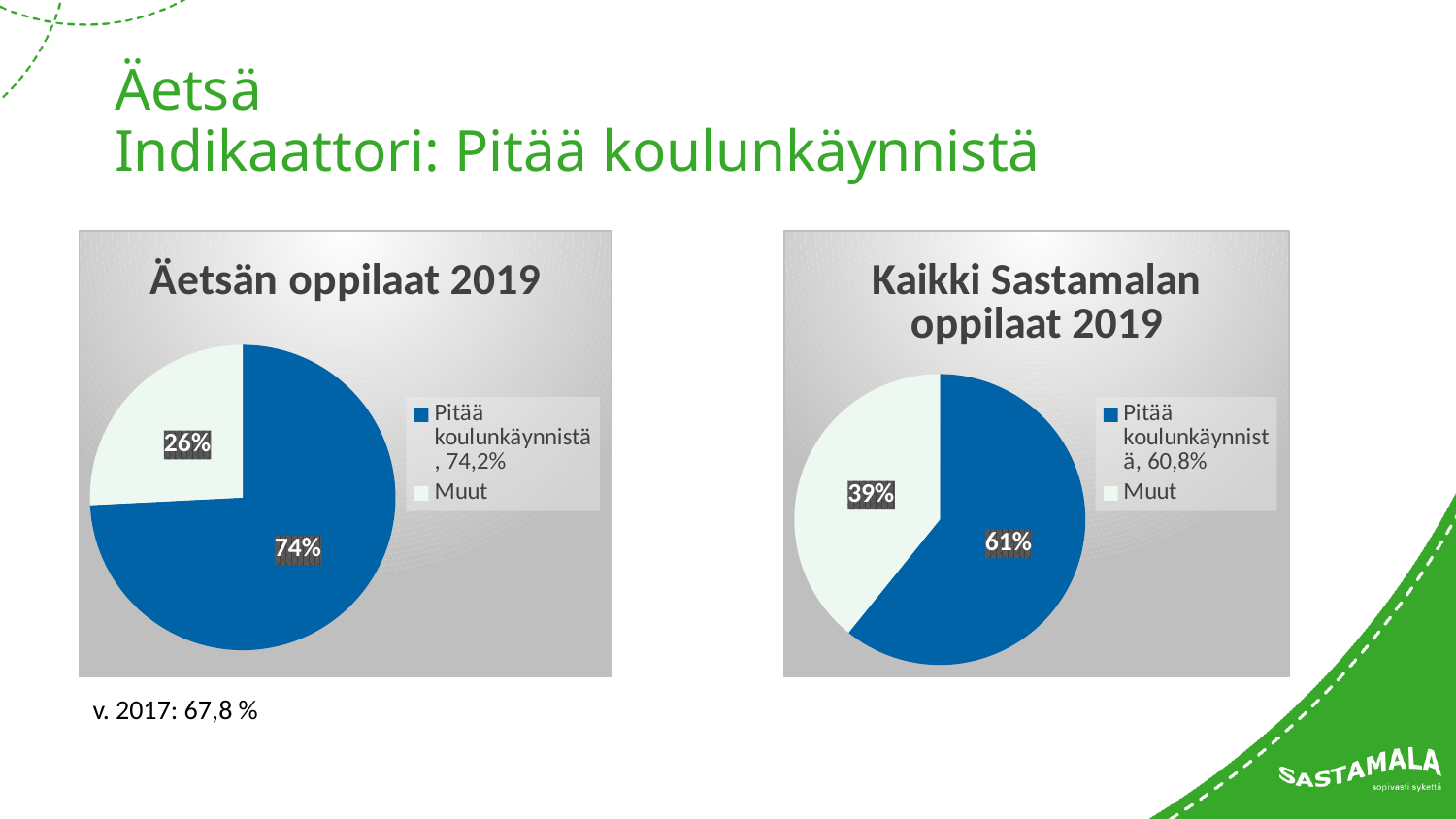
How many slices does the chart titled "Äetsän oppilaat 2019" have? 2 In the chart titled "Äetsän oppilaat 2019", what is the difference in percentage points between the "Pitää koulunkäynnistä" slice and the "Muut" slice, using the labels on the slices? 48 Which is larger: the "Pitää koulunkäynnistä" share in the "Äetsän oppilaat 2019" chart or in the "Kaikki Sastamalan oppilaat 2019" chart? Äetsän oppilaat 2019 In the chart titled "Äetsän oppilaat 2019", what percentage is shown on the "Muut" slice? 26% In the legend of the chart titled "Äetsän oppilaat 2019", what value is given next to "Pitää koulunkäynnistä"? 74,2% What kind of chart is the chart titled "Kaikki Sastamalan oppilaat 2019"? Pie chart In the chart titled "Kaikki Sastamalan oppilaat 2019", what percentage is shown on the "Muut" slice? 39% In the chart titled "Kaikki Sastamalan oppilaat 2019", which slice is the smallest? Muut In the chart titled "Äetsän oppilaat 2019", what percentage is shown on the "Pitää koulunkäynnistä" slice? 74% In the chart titled "Kaikki Sastamalan oppilaat 2019", what percentage is shown on the "Pitää koulunkäynnistä" slice? 61% In the chart titled "Äetsän oppilaat 2019", which slice is the largest? Pitää koulunkäynnistä In the legend of the chart titled "Kaikki Sastamalan oppilaat 2019", what value is given next to "Pitää koulunkäynnistä"? 60,8%